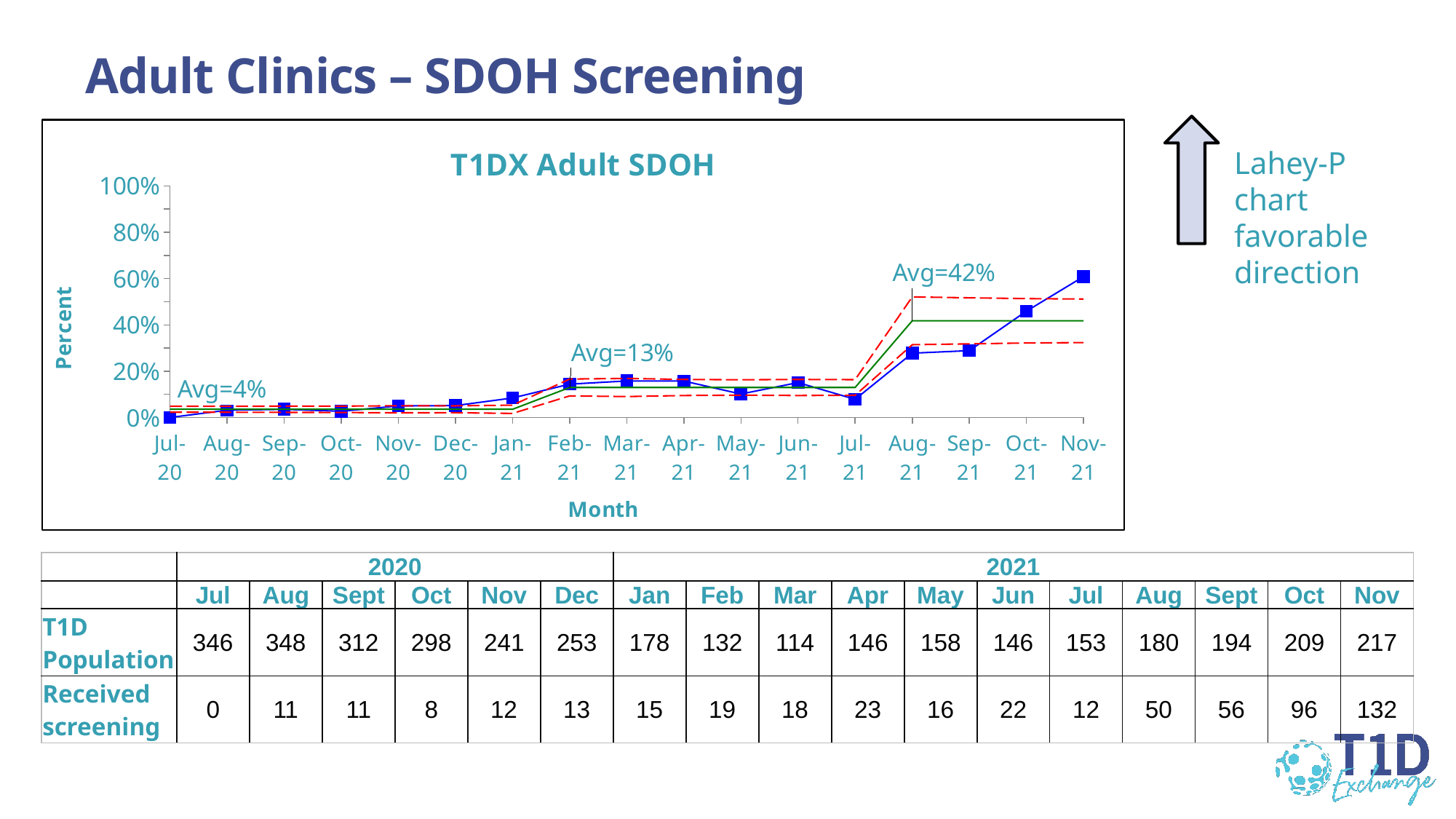
What average is annotated for the middle phase (Feb-21 to Jul-21) on the T1DX Adult SDOH chart? Avg=13% What is the plotted value for Jul-20 on the T1DX Adult SDOH chart? 0% Which month has the highest value on the T1DX Adult SDOH chart? Nov-21 Which is larger on the T1DX Adult SDOH chart, the value for Jul-21 or the value for Nov-21? Nov-21 What is the title of the chart on the slide? T1DX Adult SDOH Is the value for Nov-21 on the T1DX Adult SDOH chart greater or less than 40%? greater What kind of chart is the T1DX Adult SDOH chart? line chart What average is annotated for the final phase (Aug-21 onward) on the T1DX Adult SDOH chart? Avg=42% What is the label on the y axis of the T1DX Adult SDOH chart? Percent Is the value for Aug-21 on the T1DX Adult SDOH chart greater or less than 40%? less How many monthly data points are plotted on the T1DX Adult SDOH chart? 17 Which month has the lowest value on the T1DX Adult SDOH chart? Jul-20